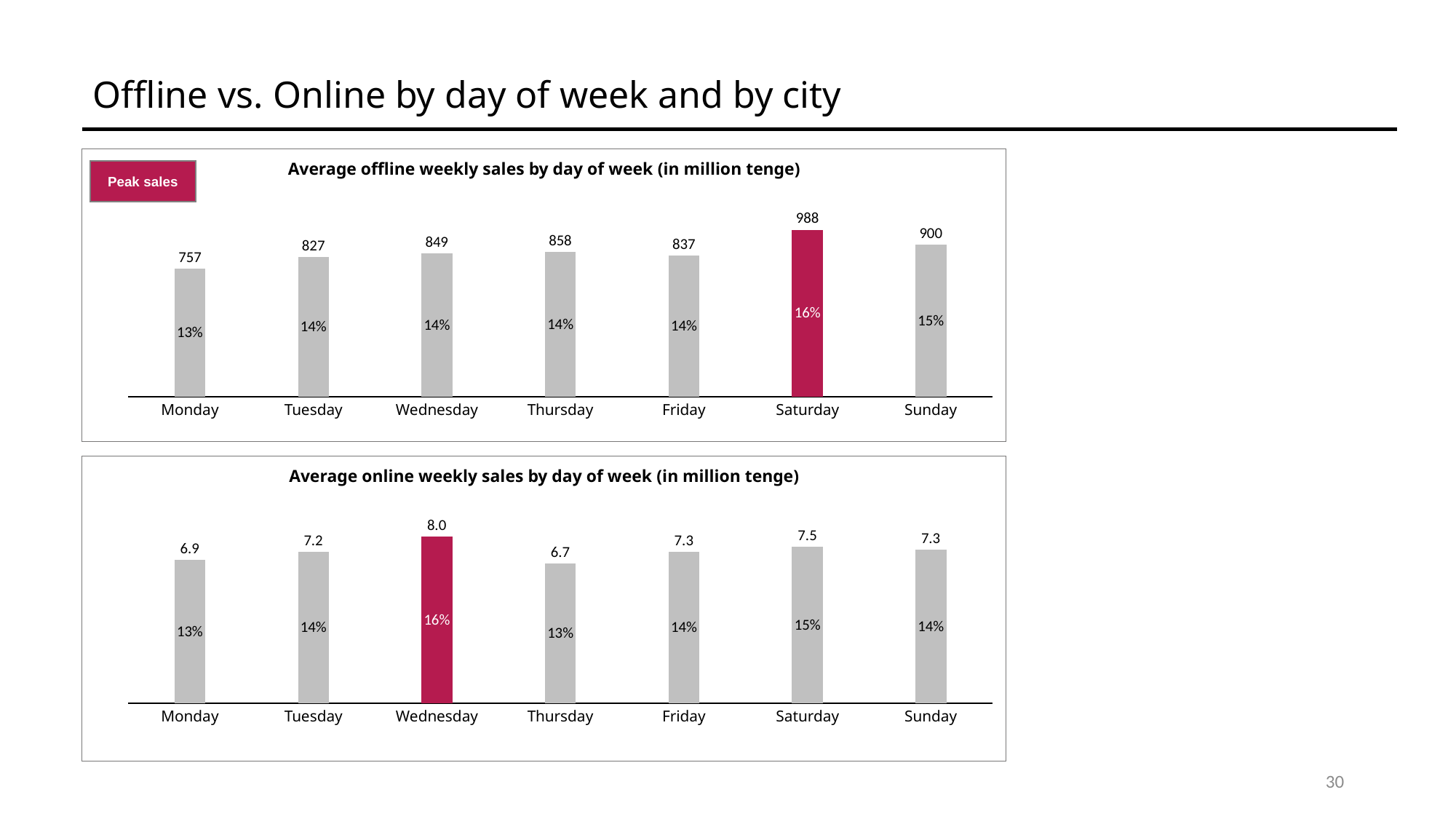
In the 'Average online weekly sales by day of week' chart, what percentage share is shown for Wednesday? 16% In the 'Average online weekly sales by day of week' chart, which day has the lowest value? Thursday In the 'Average offline weekly sales by day of week' chart, what is the value for Saturday? 988 What type of chart is the 'Average offline weekly sales by day of week' chart? Bar chart In the 'Average offline weekly sales by day of week' chart, what percentage share is shown for Sunday? 15% In the 'Average offline weekly sales by day of week' chart, what is the difference between Saturday and Monday? 231 In the 'Average offline weekly sales by day of week' chart, how many days are plotted? 7 In the 'Average offline weekly sales by day of week' chart, which day's bar is highlighted in red as the peak sales day? Saturday In the 'Average online weekly sales by day of week' chart, what is the value for Wednesday? 8.0 In the 'Average online weekly sales by day of week' chart, which is larger, Tuesday or Saturday? Saturday In the 'Average offline weekly sales by day of week' chart, which day has the lowest value? Monday In the 'Average online weekly sales by day of week' chart, what is the difference between Wednesday and Thursday? 1.3